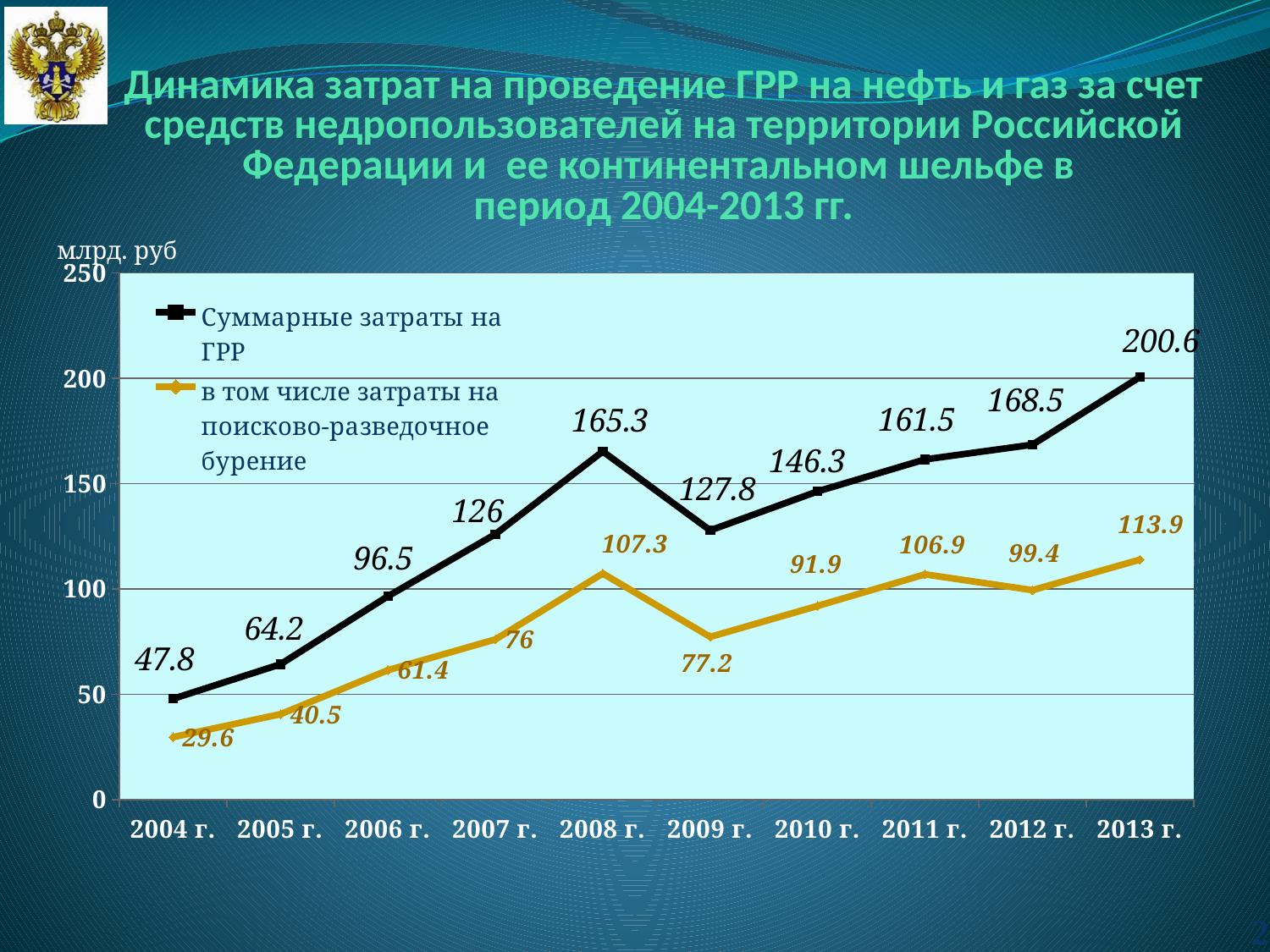
What is the difference between 'Суммарные затраты на ГРР' and 'в том числе затраты на поисково-разведочное бурение' in 2013 г.? 86.7 What unit is shown above the vertical axis? млрд. руб How many years are shown on the x axis? 10 How many series does the legend list? 2 In which year is 'Суммарные затраты на ГРР' highest? 2013 г. In which year is 'в том числе затраты на поисково-разведочное бурение' lowest? 2004 г. What is the value of 'в том числе затраты на поисково-разведочное бурение' for 2011 г.? 106.9 Which is larger: 'Суммарные затраты на ГРР' in 2008 г. or in 2009 г.? 2008 г. What kind of chart is shown on the slide? line chart What is the value of 'Суммарные затраты на ГРР' for 2008 г.? 165.3 Is the value of 'в том числе затраты на поисково-разведочное бурение' for 2012 г. greater or less than 100? less What is the value of 'Суммарные затраты на ГРР' for 2004 г.? 47.8